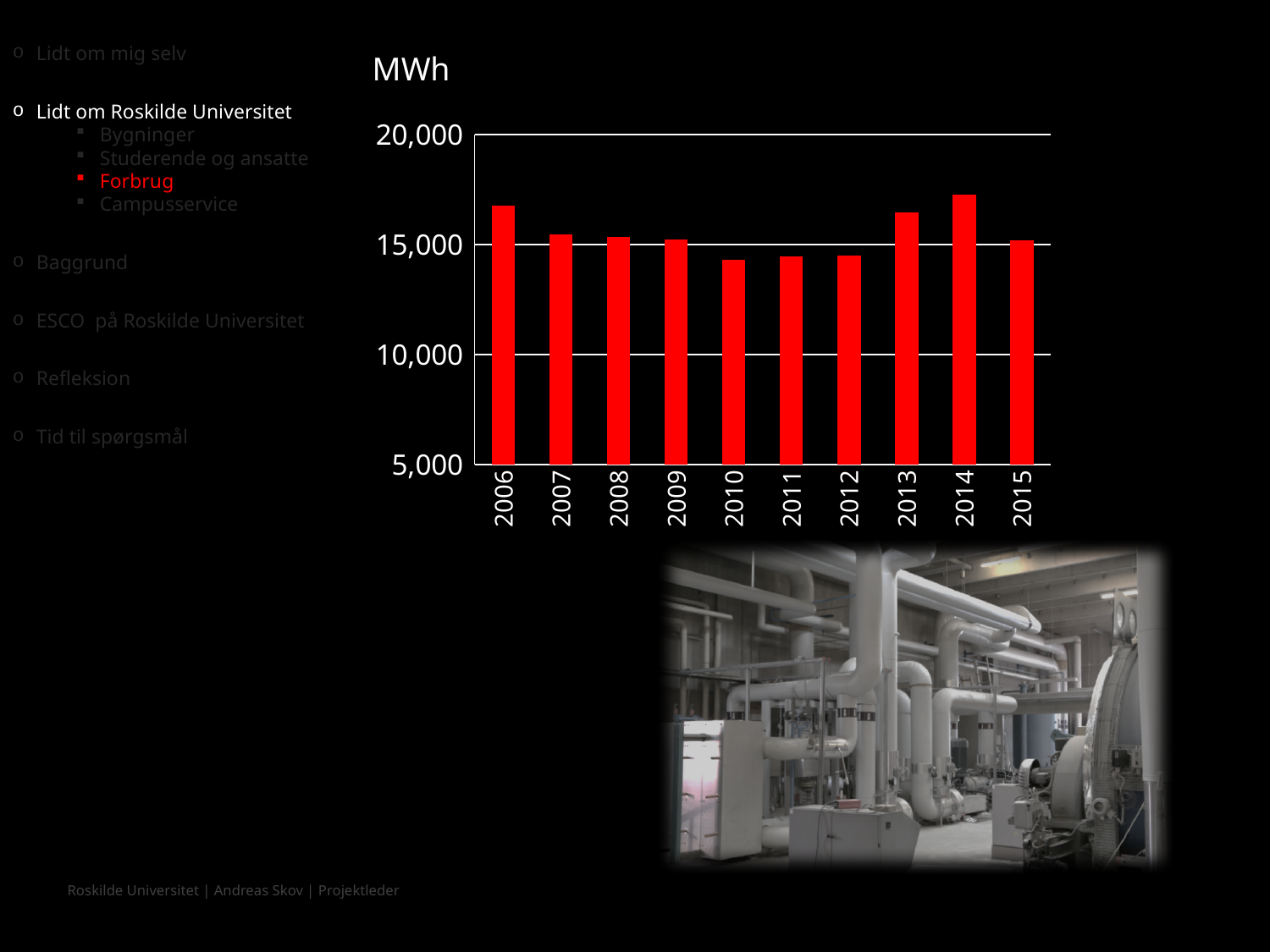
What kind of chart is shown on the slide? bar chart Which is larger, the value for 2006 or the value for 2007? 2006 Is the value for 2011 greater or less than 15,000? less Is the value for 2014 greater or less than 15,000? greater Which is larger, the value for 2014 or the value for 2010? 2014 Is the value for 2013 greater or less than 20,000? less Do the values rise or fall from 2006 to 2010? fall What unit is shown above the chart's y axis? MWh How many years are shown on the x axis of the chart? 10 Which year has the highest bar in the chart? 2014